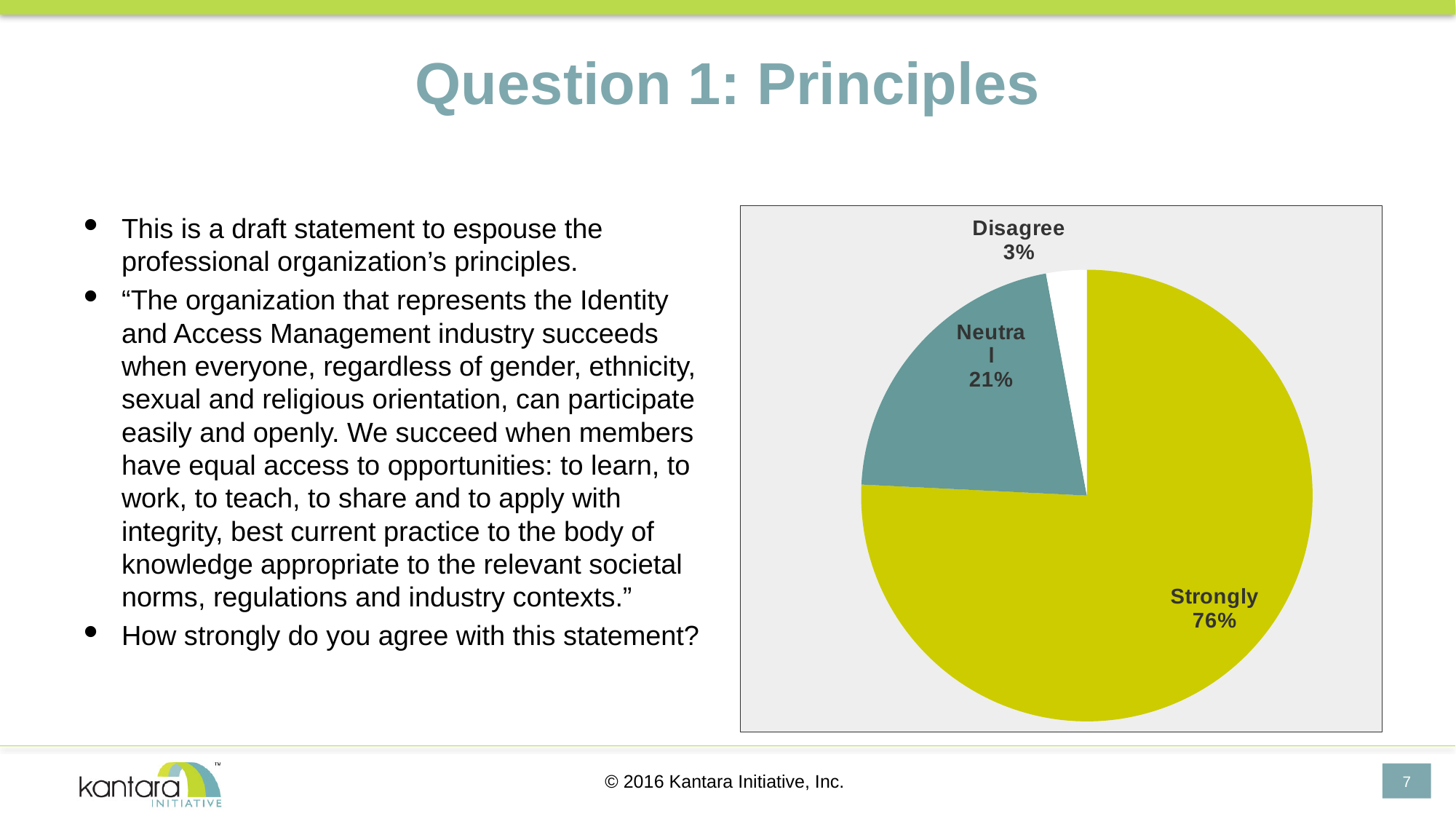
What share of the pie does the Strongly slice represent? 76% What is the difference in percentage points between the Neutral and Disagree slices? 18 Which slice of the pie chart is the largest? Strongly Which slice of the pie chart is the smallest? Disagree How many slices does the pie chart have? 3 What share of the pie does the Neutral slice represent? 21% Which is larger, the Neutral slice or the Disagree slice? Neutral What is the difference in percentage points between the Strongly and Neutral slices? 55 What colour is the Strongly slice of the pie chart? yellow-green What share of the pie does the Disagree slice represent? 3% What colour is the Neutral slice of the pie chart? teal What kind of chart is shown on the slide? pie chart